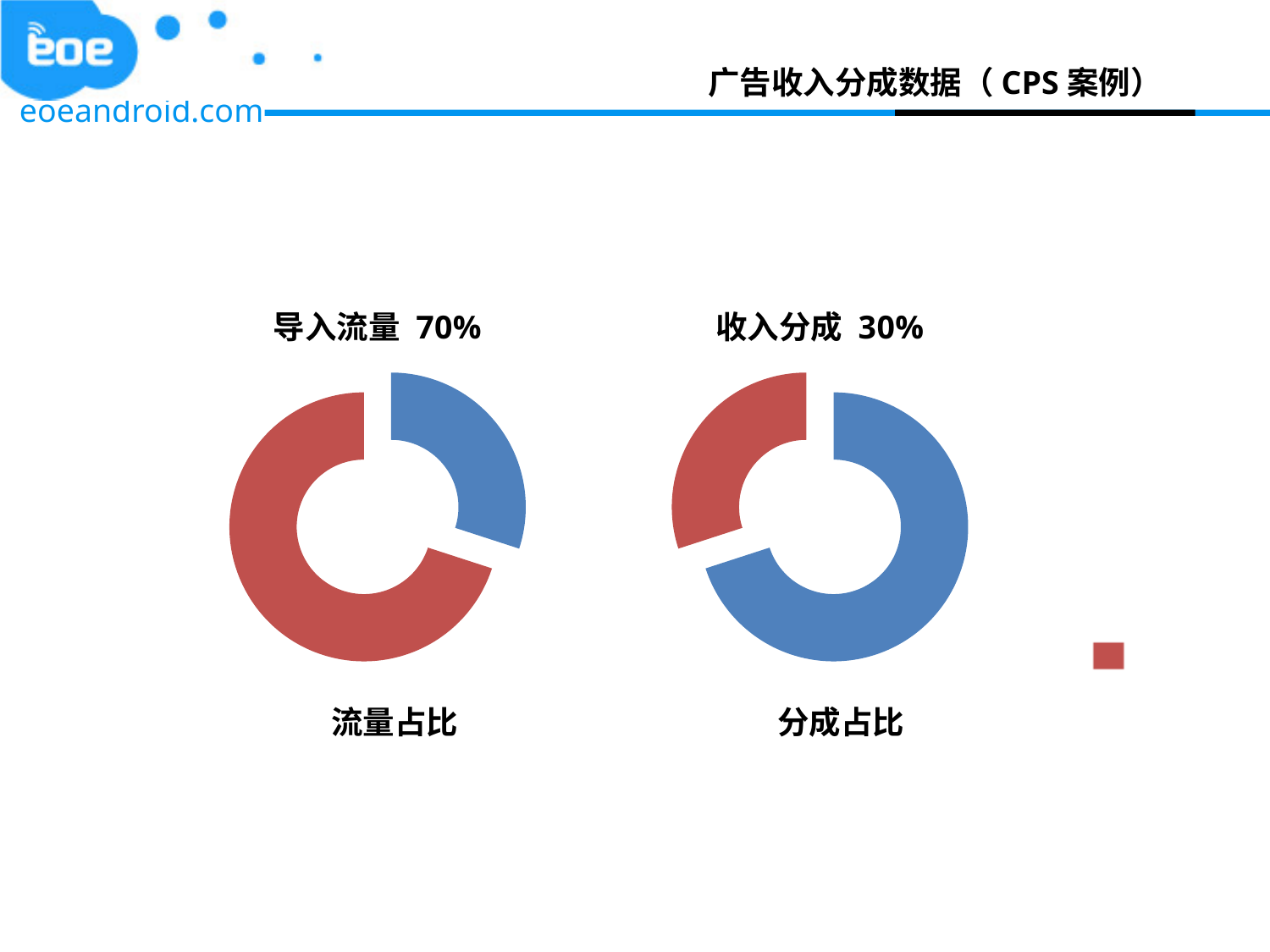
How many slices does the left chart titled 流量占比 have? 2 Is the 收入分成 share in the right chart titled 分成占比 greater or less than 50%? less What is the title of the chart on the left side of the slide? 导入流量 70% In the right chart titled 分成占比, what percentage is shown for 收入分成? 30% Is the 导入流量 share in the left chart titled 流量占比 greater or less than 50%? greater In the left chart titled 流量占比, what percentage is shown for 导入流量? 70% What kind of chart is the right chart titled 分成占比? Doughnut (pie) chart In the right chart titled 分成占比, which slice is larger, the red one or the blue one? The blue one What kind of chart is the left chart titled 流量占比? Doughnut (pie) chart In the left chart titled 流量占比, which slice is larger, the red one or the blue one? The red one How many slices does the right chart titled 分成占比 have? 2 What colour is the 导入流量 70% slice in the left chart titled 流量占比? Red